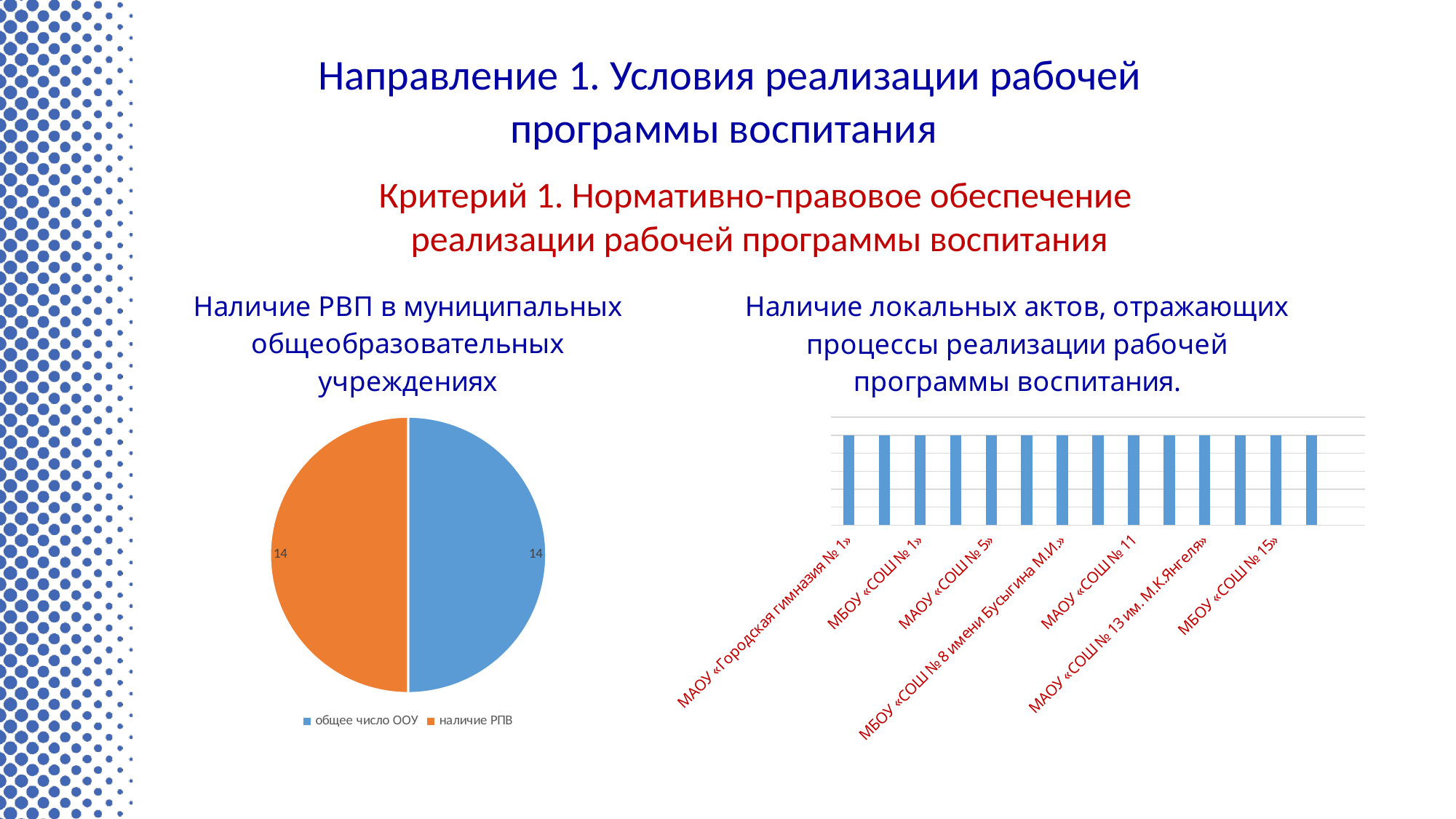
On the pie chart on the left, how many slices are there? 2 On the bar chart on the right, what is the label of the first category on the x axis? МАОУ «Городская гимназия № 1» On the pie chart titled «Наличие РВП в муниципальных общеобразовательных учреждениях», what value is shown for «наличие РПВ»? 14 On the pie chart titled «Наличие РВП в муниципальных общеобразовательных учреждениях», what value is shown for «общее число ООУ»? 14 On the pie chart on the left, how many entries does the legend list? 2 On the pie chart on the left, which colour represents «наличие РПВ»? Orange On the pie chart on the left, are the values for «общее число ООУ» and «наличие РПВ» equal or different? Equal On the pie chart on the left, what share of the pie does the «наличие РПВ» slice represent? 50% What kind of chart is the chart on the right of the slide, under the heading «Наличие локальных актов, отражающих процессы реализации рабочей программы воспитания.»? Bar chart On the bar chart on the right, how many bars are plotted? 14 On the bar chart on the right, do the bar heights rise, fall, or stay the same across the categories? Stay the same What kind of chart is the chart on the left of the slide? Pie chart